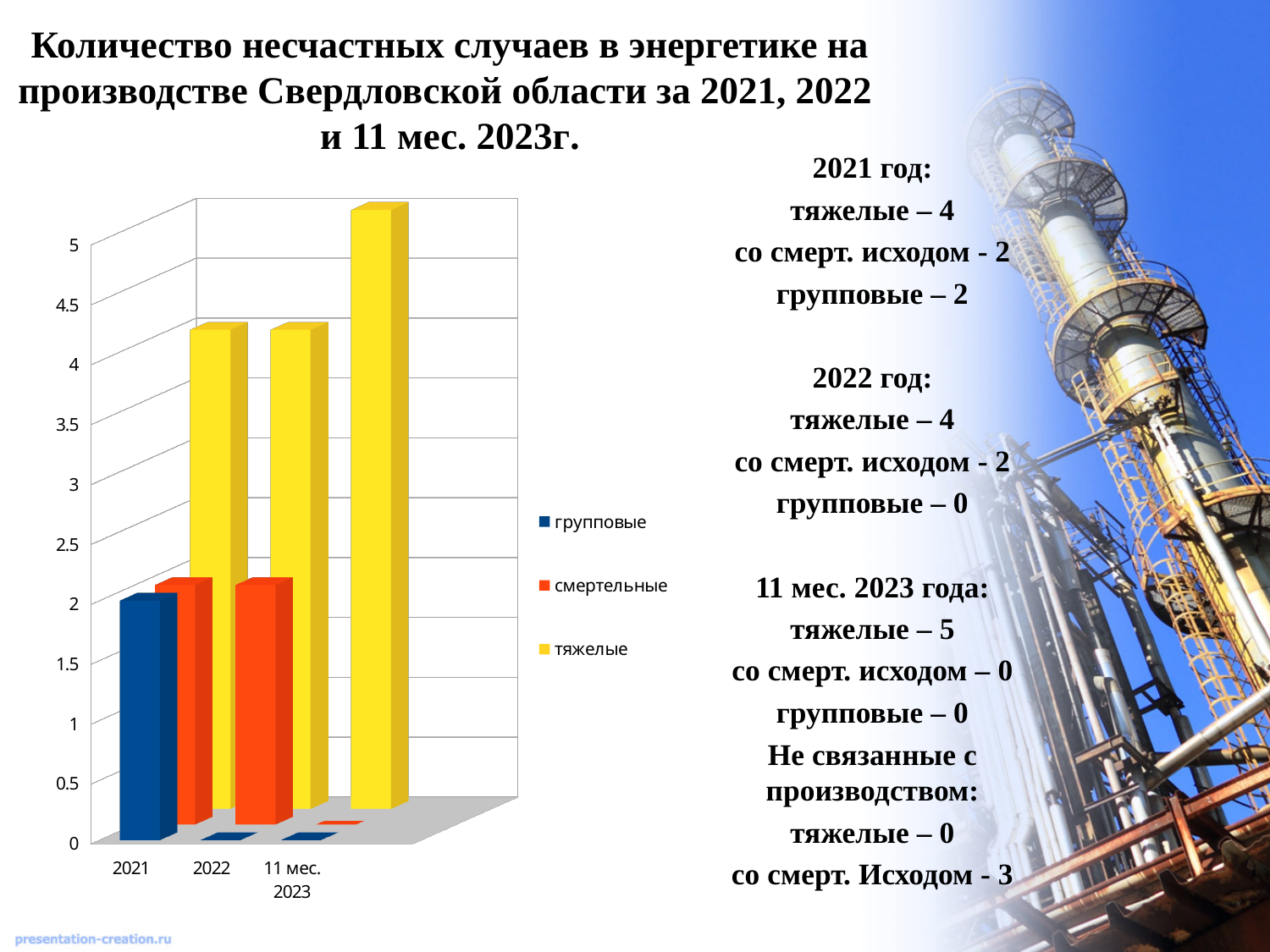
How many categories are shown on the x axis of the chart? 3 Which colour represents the series тяжелые in the legend? yellow What kind of chart is shown on the slide? bar chart Which category has the highest value for тяжелые? 11 мес. 2023 Is the value of тяжелые for 11 мес. 2023 greater or less than 4.5? greater What is the value of тяжелые for 11 мес. 2023? 5 Is the value of групповые for 2021 greater or less than 1? greater In 2022, which is larger: тяжелые or смертельные? тяжелые What is the value of тяжелые for 2021? 4 What is the difference between тяжелые for 11 мес. 2023 and тяжелые for 2021? 1 How many series does the chart legend list? 3 What is the value of смертельные for 2022? 2